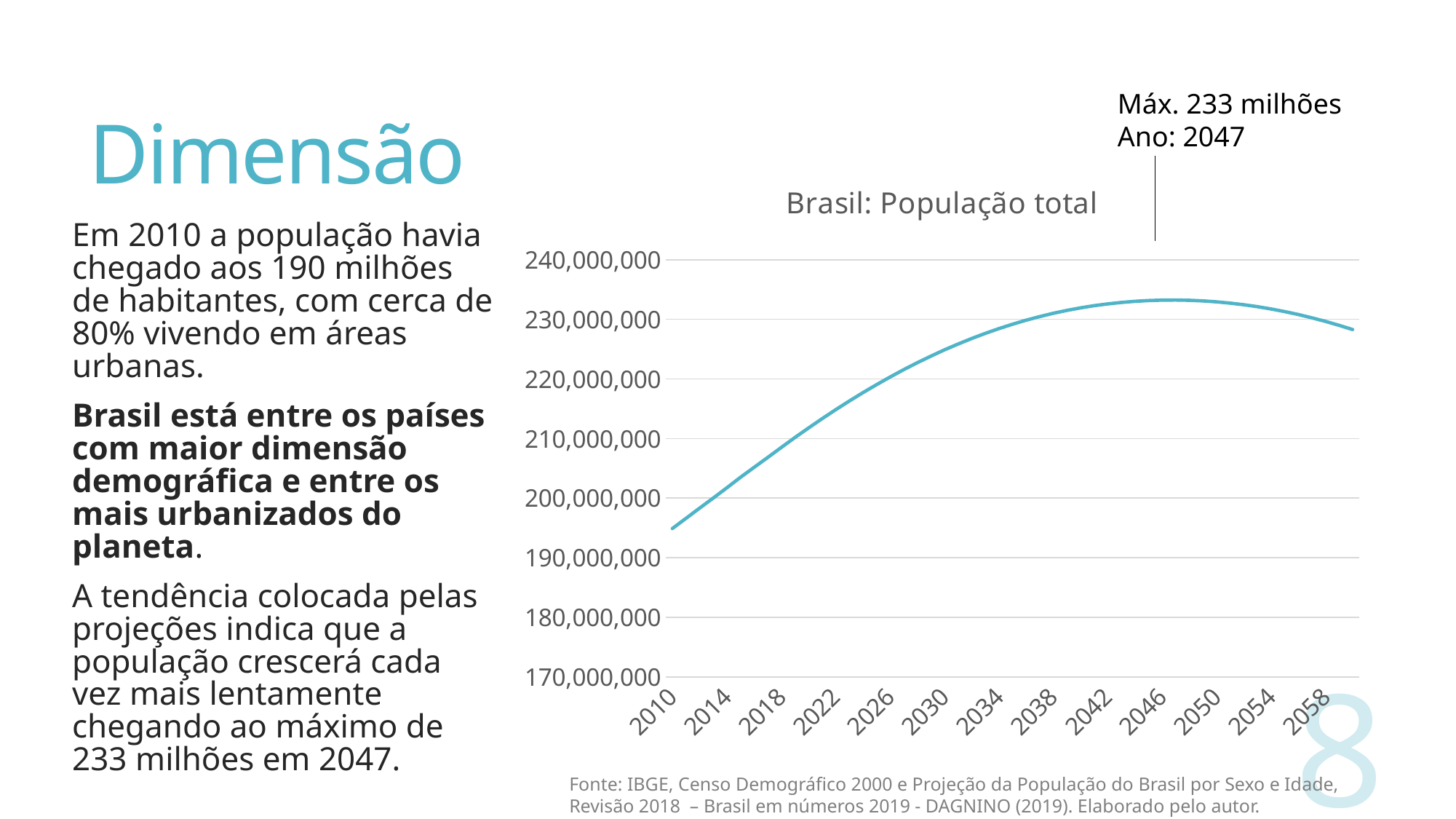
Which year has the larger population value, 2010 or 2058? 2058 Is the population value for 2058 greater or less than 220,000,000? greater Does the population line rise or fall between 2050 and 2058? fall Does the population line rise or fall between 2010 and 2046? rise What is the title of the chart? Brasil: População total According to the annotation on the chart, in which year does the population reach its maximum? 2047 What kind of chart is shown on the slide? line chart Is the population value for 2010 greater or less than 200,000,000? less Which year has the larger population value, 2018 or 2042? 2042 According to the annotation on the chart, what is the maximum population value? 233 milhões Is the population value for 2030 greater or less than 220,000,000? greater How many year labels are shown on the x axis of the chart? 13